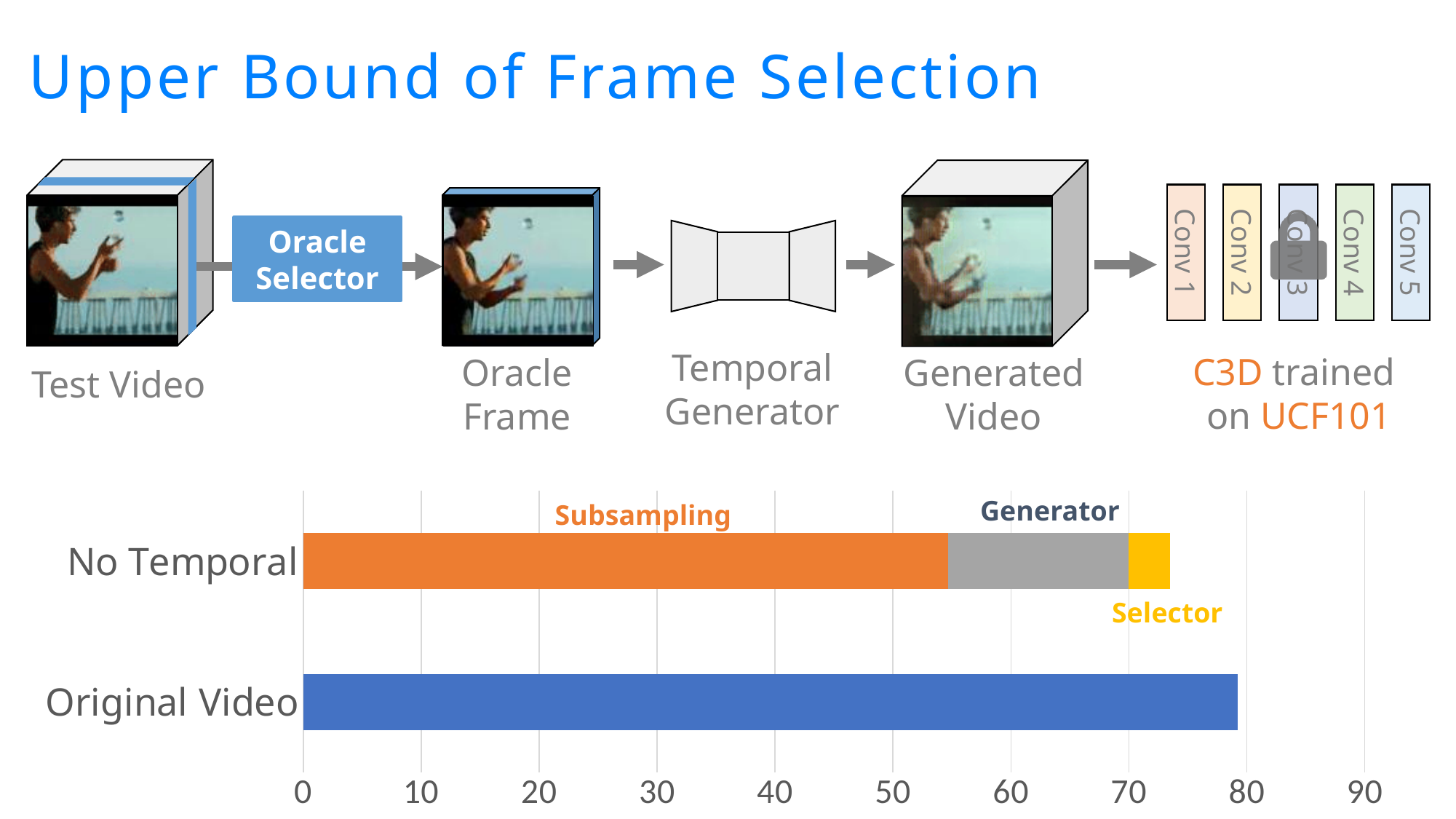
Is the value for Original Video greater or less than 70? greater How many labelled segments make up the No Temporal bar? 3 Is the Subsampling segment of the No Temporal bar greater or less than 50? greater Is the total value of the No Temporal bar greater or less than 70? greater Which category has the longer bar, No Temporal or Original Video? Original Video What colour is the Original Video bar? blue Which category has the lowest total value on the bar chart? No Temporal What kind of chart is shown at the bottom of the slide? bar chart Which segment of the No Temporal bar is coloured yellow? Selector Which category has the highest total value on the bar chart? Original Video How many categories are plotted on the bar chart? 2